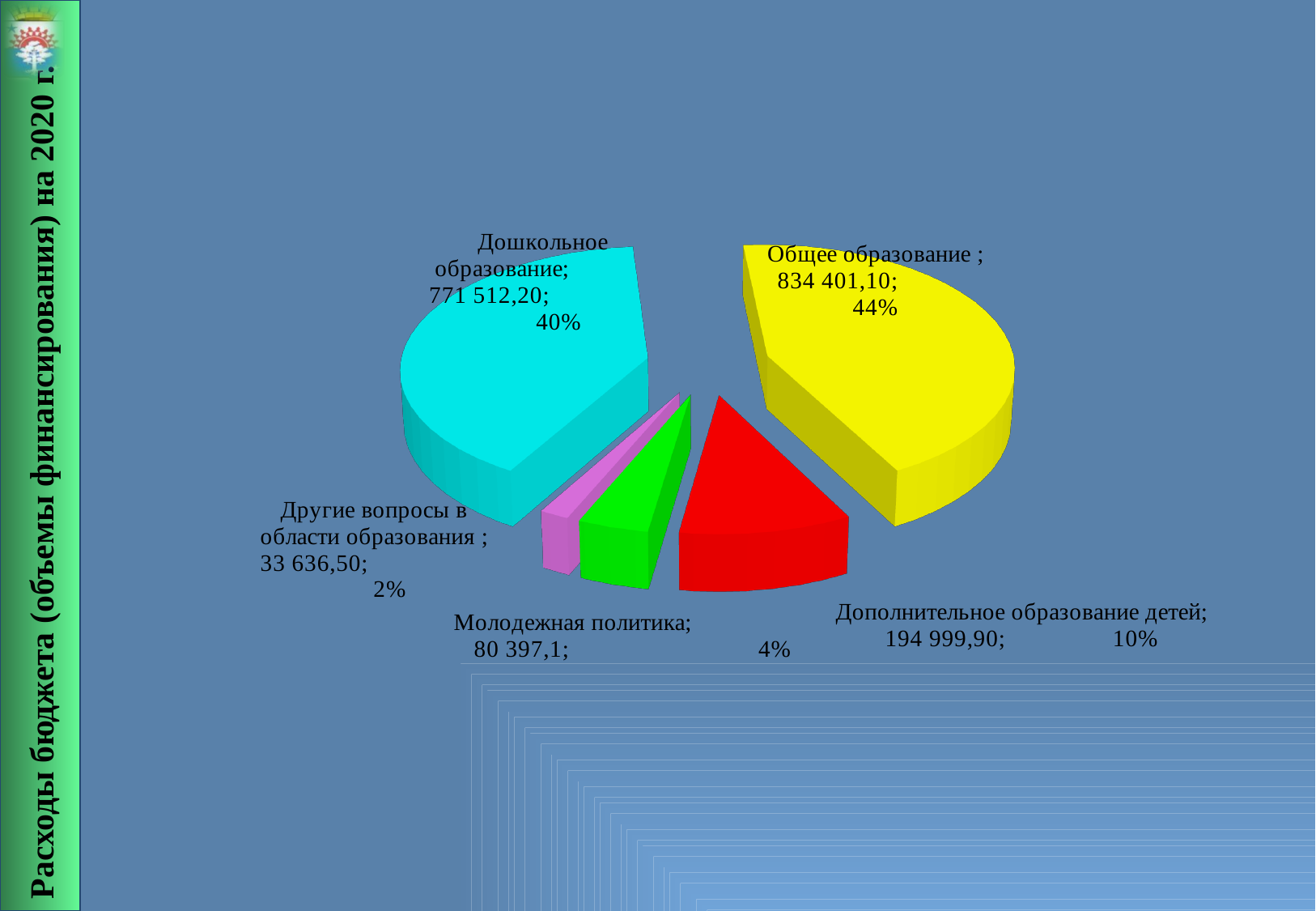
What kind of chart is shown on the slide? Pie chart What value is shown for Общее образование? 834 401,10 What value is shown for Дополнительное образование детей? 194 999,90 How many slices does the pie chart have? 5 Which is larger, the value for Дополнительное образование детей or Молодежная политика? Дополнительное образование детей Which category has the smallest slice? Другие вопросы в области образования What value is shown for Молодежная политика? 80 397,1 What share of the pie does Общее образование take? 44% What share of the pie does Другие вопросы в области образования take? 2% What is the difference between the values for Общее образование and Дошкольное образование? 62 888,90 What value is shown for Дошкольное образование? 771 512,20 Which category has the largest slice? Общее образование